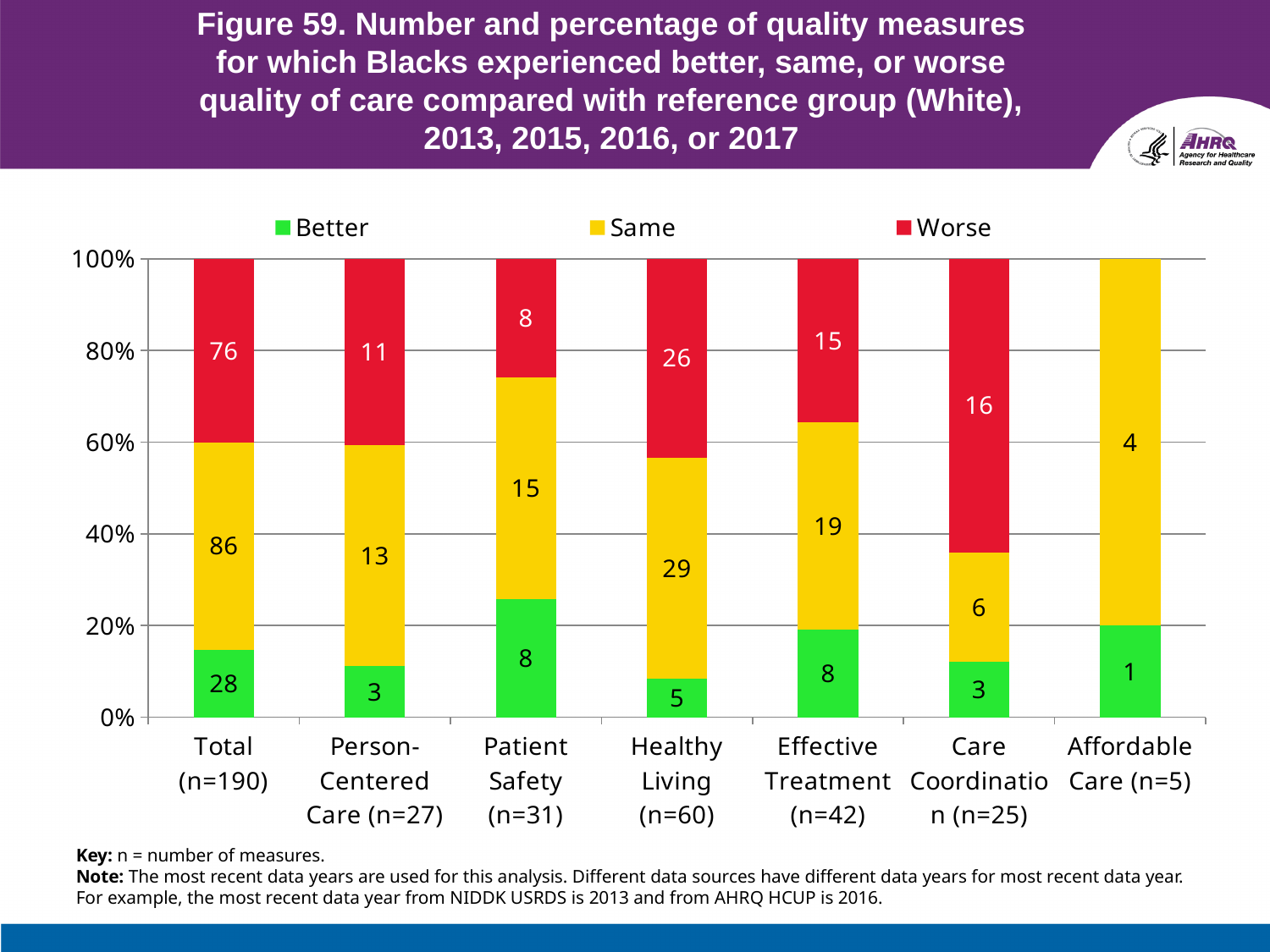
How many quality measures did Blacks experience worse quality of care for in the Total category? 76 What is the total number of measures in the Person-Centered Care bar (Better + Same + Worse)? 27 What is the difference between the 'Same' and 'Worse' counts for Effective Treatment? 4 Is the 'Better' share of the Patient Safety bar greater or less than 20%? greater Which is larger for Care Coordination: the 'Worse' count or the 'Same' count? Worse Which category has the highest number of 'Worse' measures? Total (n=190) How many categories are shown on the x axis? 7 How many series does the legend list? 3 What kind of chart is shown on the slide? Stacked bar chart How many 'Better' measures are shown for Care Coordination? 3 Excluding Total, which category has the lowest number of 'Same' measures? Affordable Care (n=5) What is the number of 'Same' measures for Healthy Living? 29